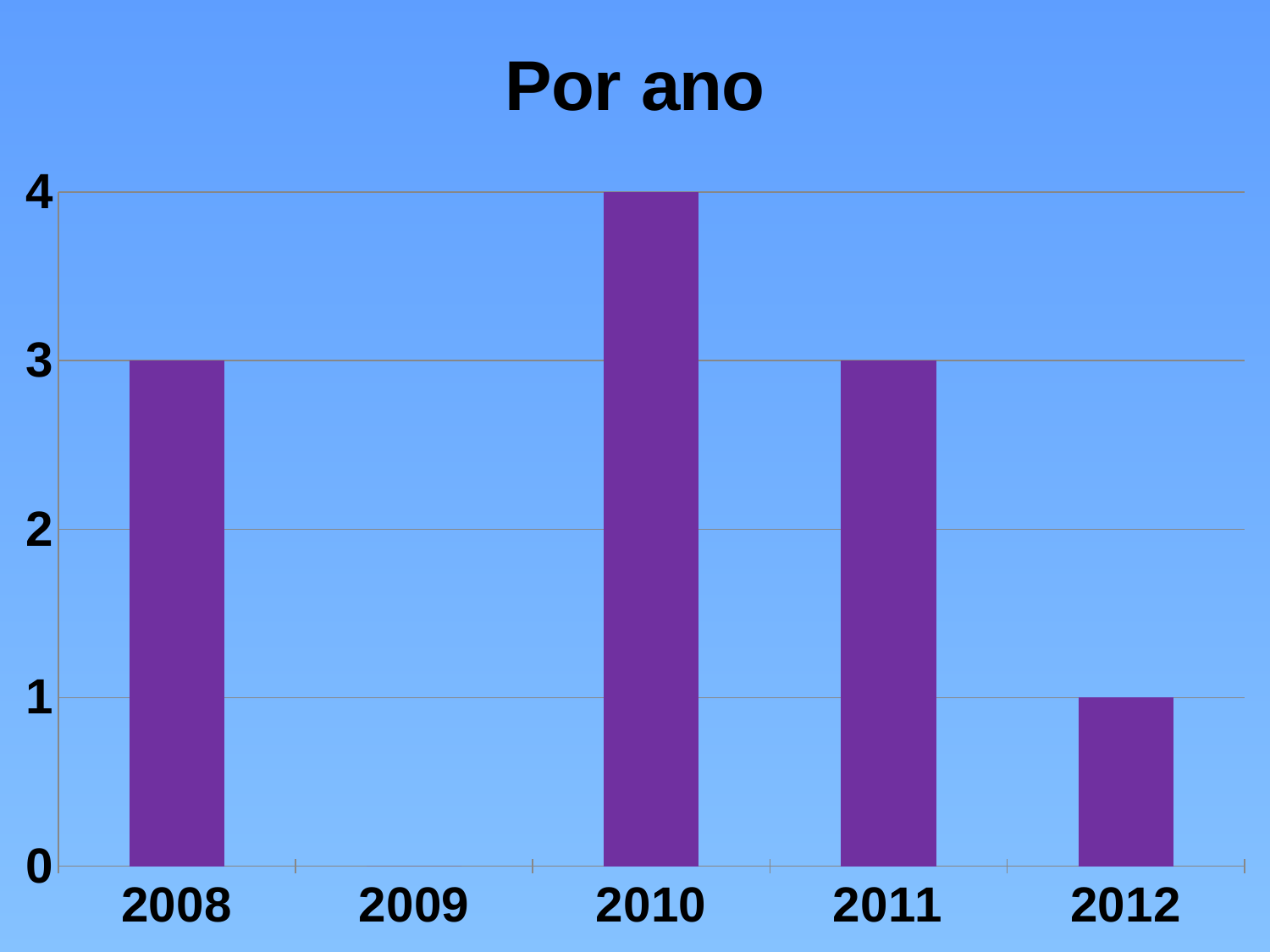
What is the value for 2010? 4 Is the value for 2012 greater or less than 2? less What is the value for 2011? 3 How many years are shown on the x axis? 5 Which year has the highest value? 2010 What is the difference between the values for 2010 and 2012? 3 What is the difference between the values for 2010 and 2008? 1 What is the value for 2012? 1 What is the value for 2008? 3 What kind of chart is shown on the slide? bar chart What is the title of the chart? Por ano Which has the larger value, 2008 or 2012? 2008